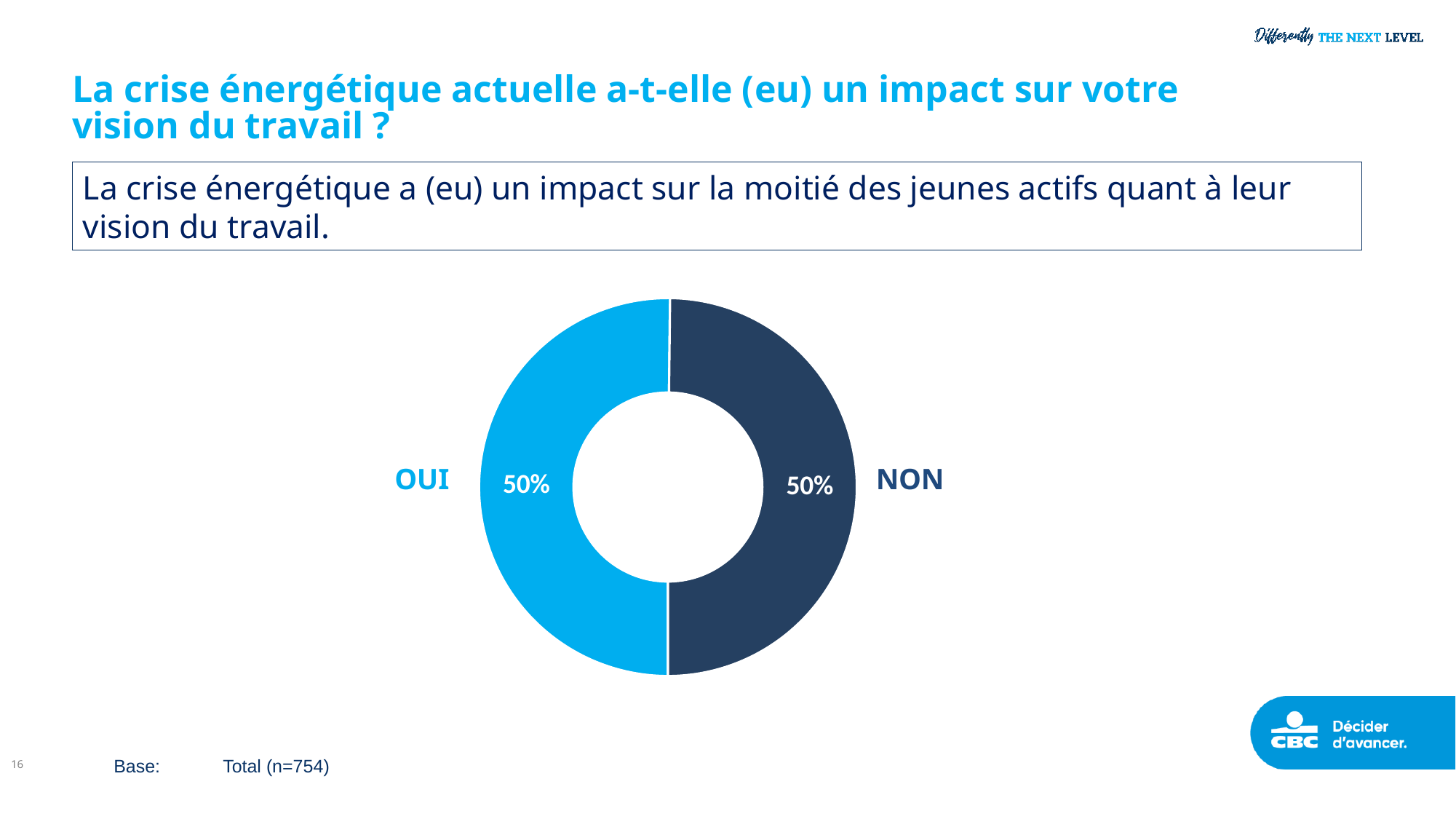
Which slice is shown in light blue? OUI What is the value shown for NON? 50% What is the difference between the OUI and NON values? 0% Is the value for NON greater or less than 60%? less What is the value shown for OUI? 50% What is the base (sample size) stated for the chart? Total (n=754) What kind of chart is shown on the slide? Pie chart (doughnut) What share of the pie does the OUI slice represent? 50% How many slices does the chart have? 2 What is the total of the OUI and NON values? 100% Is the value for OUI greater or less than 40%? greater What share of the pie does the NON slice represent? 50%